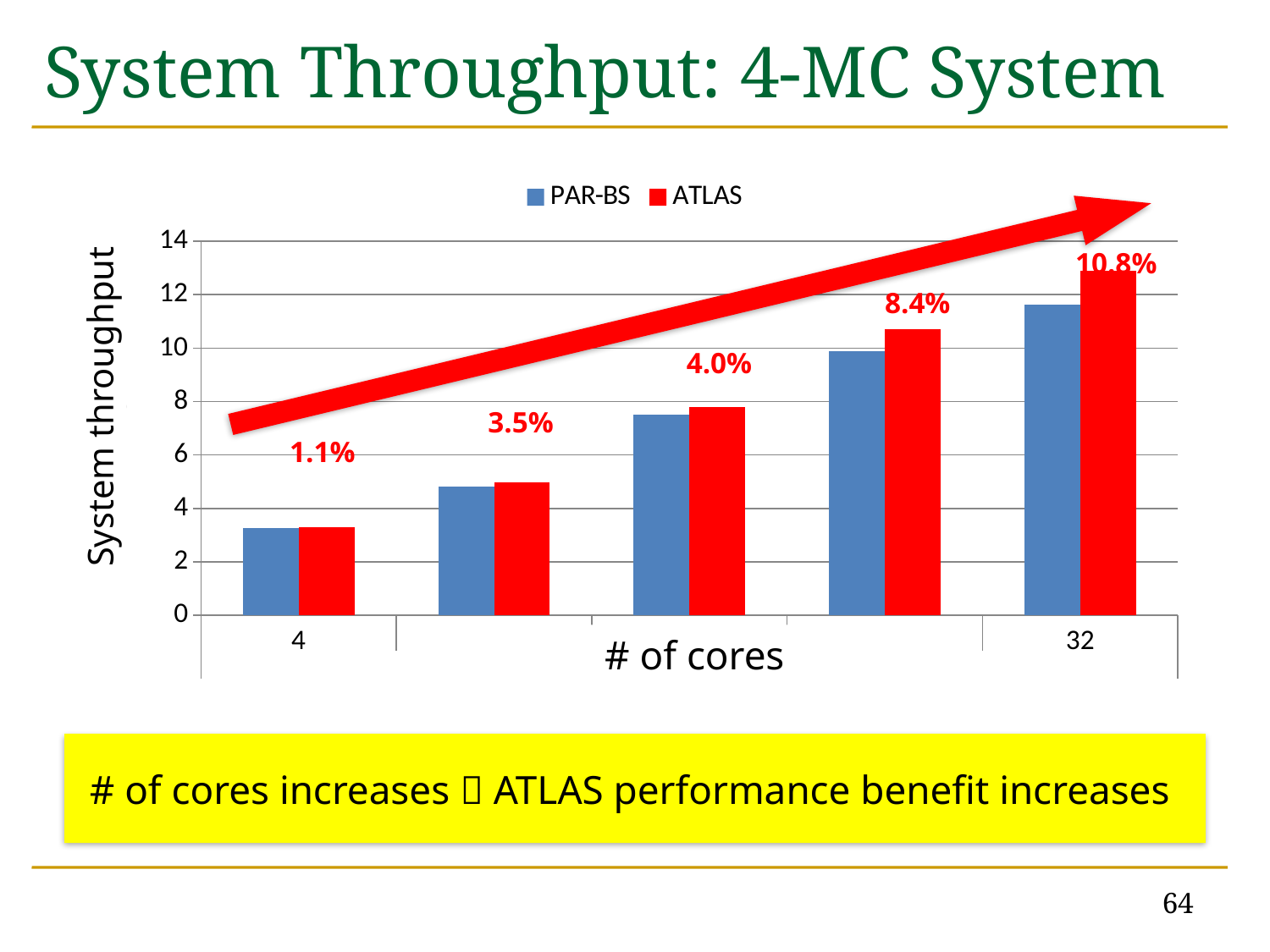
Is the PAR-BS system throughput for 32 cores greater or less than 12? less What kind of chart is shown on the slide? bar chart Do the system throughput values rise or fall as the number of cores increases? rise Is the PAR-BS system throughput for 4 cores greater or less than 4? less At which number of cores is the ATLAS system throughput highest? 32 How many groups of bars are plotted along the x axis? 5 What percentage label is shown above the bars for 4 cores? 1.1% Is the ATLAS system throughput for 32 cores greater or less than 12? greater How many series does the legend list? 2 What is the title of the y axis? System throughput For 32 cores, which series has the higher system throughput, PAR-BS or ATLAS? ATLAS What percentage label is shown above the bars for 32 cores? 10.8%